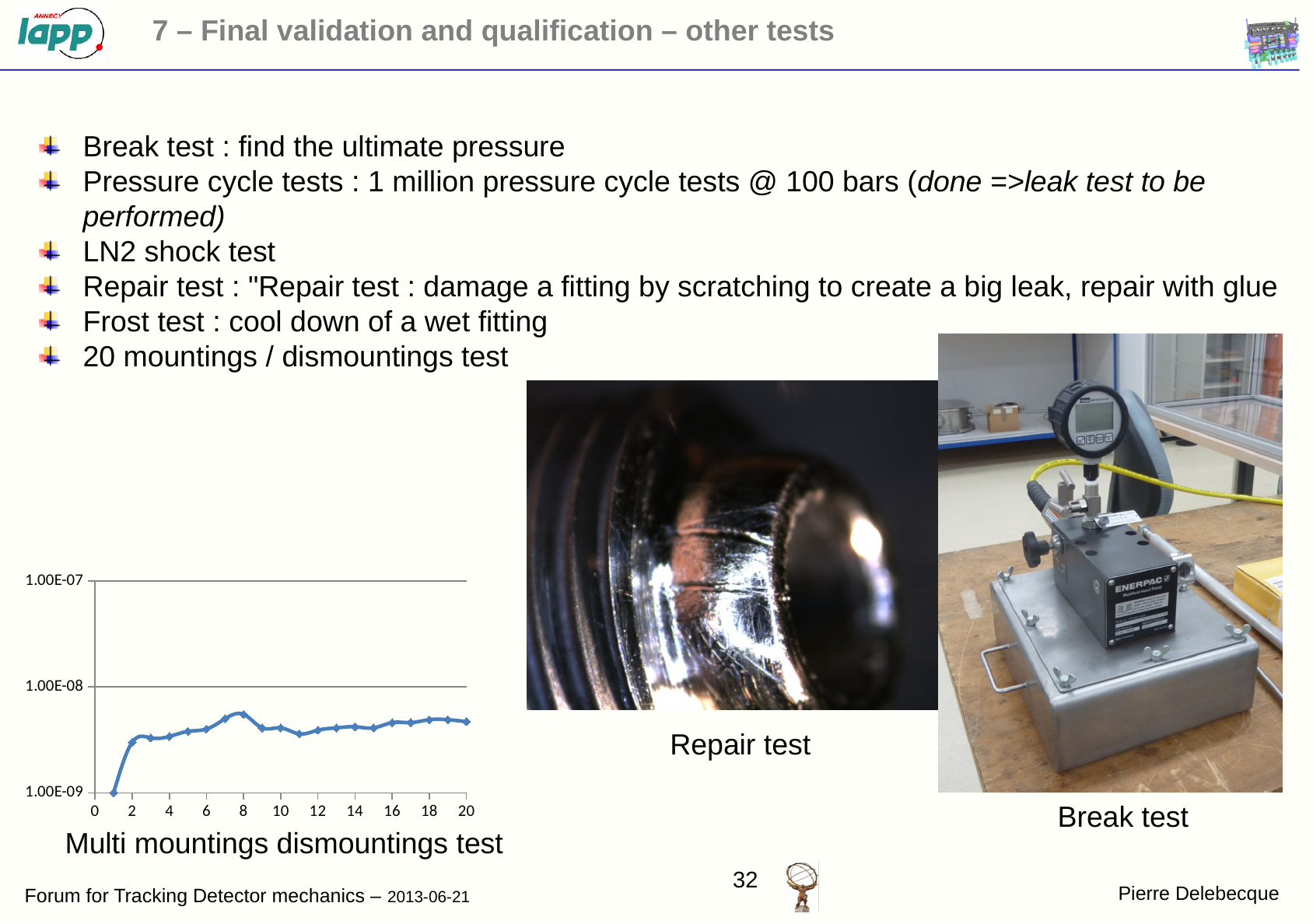
What kind of chart is shown at the bottom left of the slide? line chart How many data points are plotted on the Multi mountings dismountings test chart? 20 On the Multi mountings dismountings test chart, is the value at x = 20 greater or less than 1.00E-08? less On the Multi mountings dismountings test chart, at which x value is the plotted value lowest? 1 On the Multi mountings dismountings test chart, which has the larger value: x = 2 or x = 8? x = 8 On the Multi mountings dismountings test chart, do the values rise or fall between x = 1 and x = 8? rise On the Multi mountings dismountings test chart, at which x value is the plotted value highest? 8 On the Multi mountings dismountings test chart, which has the larger value: x = 1 or x = 4? x = 4 What caption is written under the chart at the bottom left of the slide? Multi mountings dismountings test On the Multi mountings dismountings test chart, is the value at x = 8 greater or less than 1.00E-08? less On the Multi mountings dismountings test chart, is the value at x = 10 greater or less than 1.00E-09? greater What is the highest tick label shown on the y axis of the Multi mountings dismountings test chart? 1.00E-07